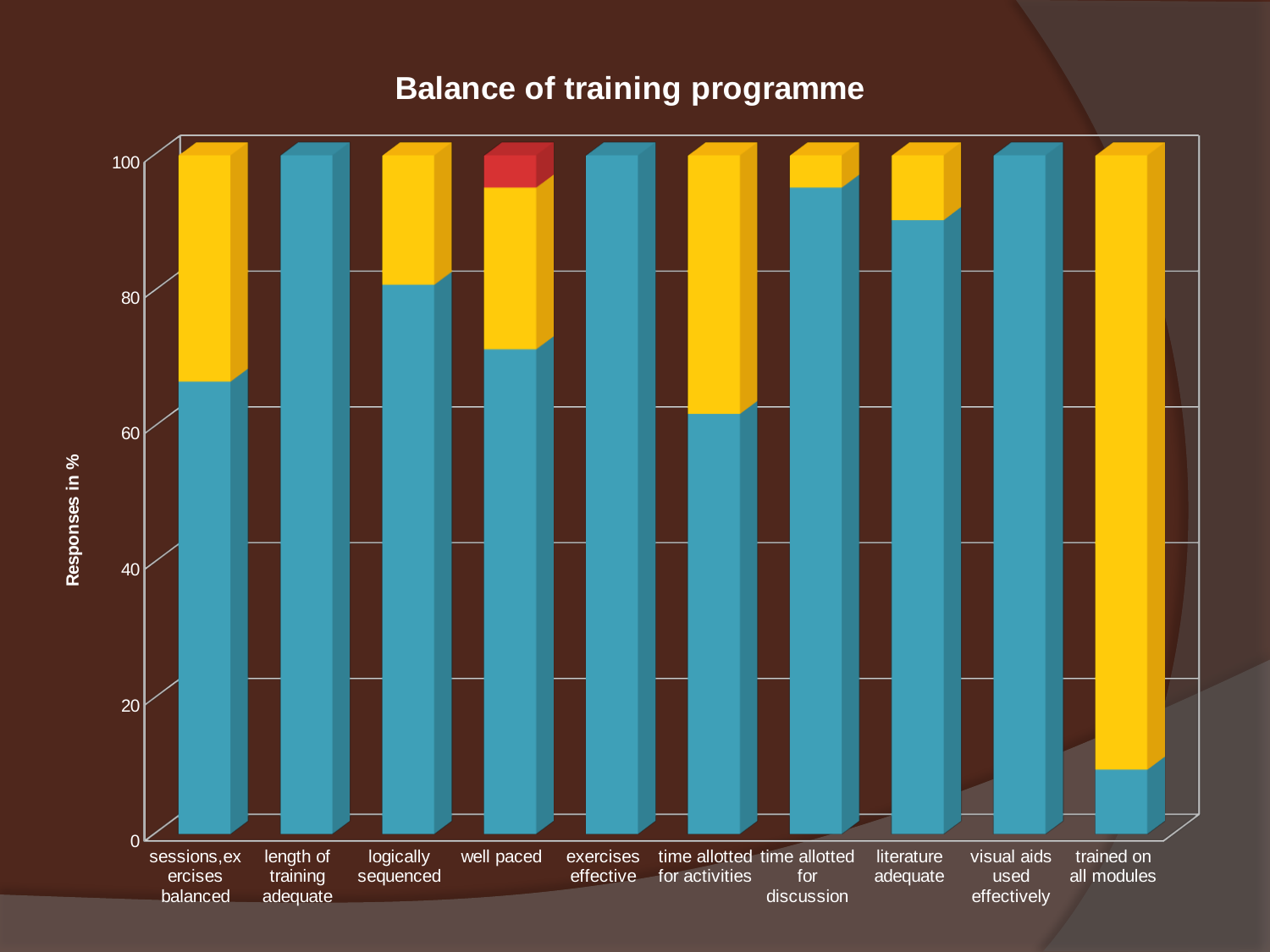
What is the label on the vertical axis of the chart? Responses in % Which category is the only one with a red segment? well paced Which category has the largest yellow segment? trained on all modules What kind of chart is shown on the slide? Stacked bar chart Is the blue segment for 'sessions, exercises balanced' greater or less than 60? greater Is the blue segment for 'length of training adequate' larger than the blue segment for 'time allotted for activities'? Yes How many categories are shown along the x axis of the chart? 10 Is the blue segment for 'trained on all modules' greater or less than 20? less Is the blue segment for 'literature adequate' greater or less than 80? greater Which category has the smallest blue segment? trained on all modules What is the title of the chart? Balance of training programme